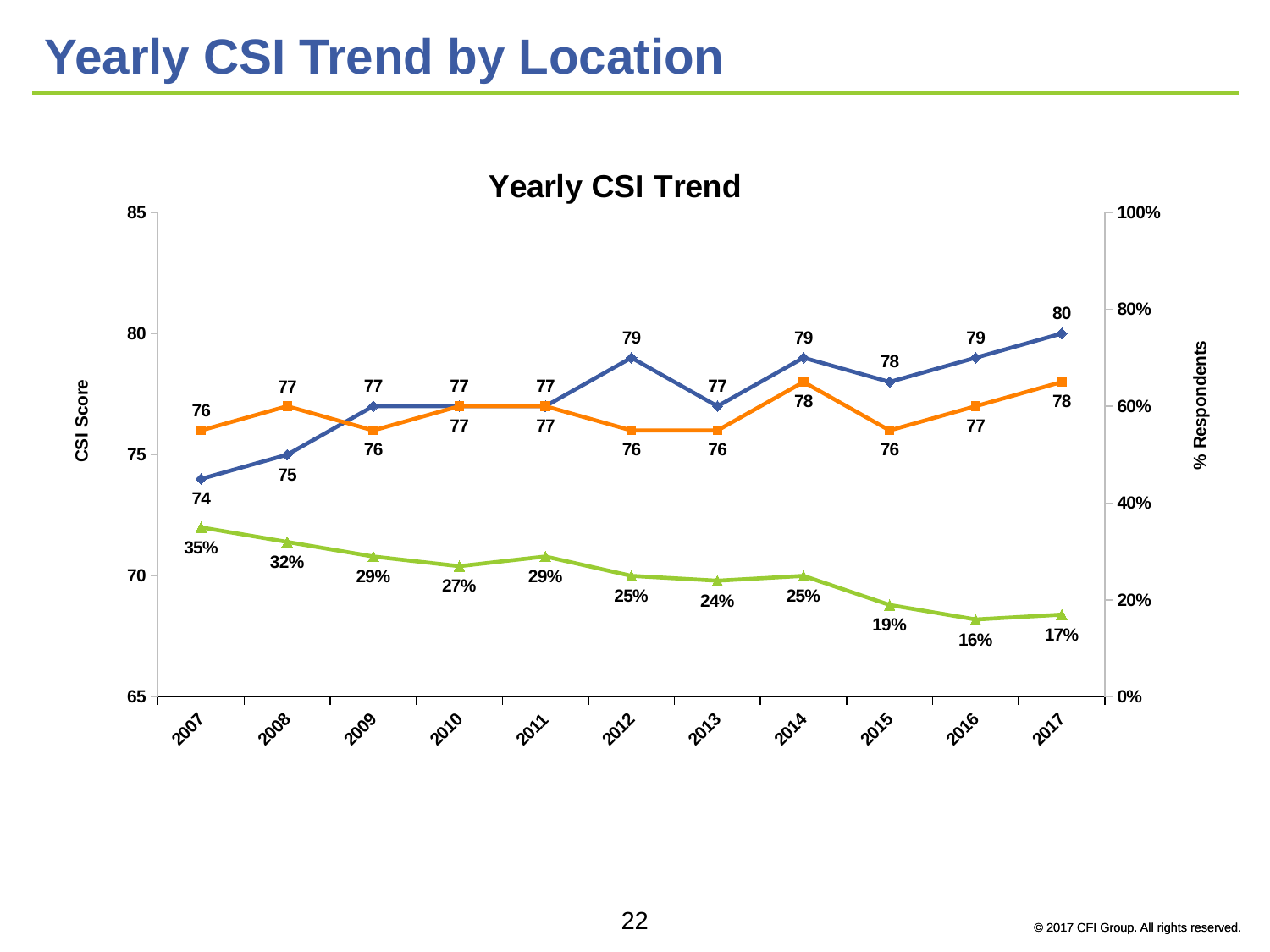
What is the value of the blue line in 2017? 80 In which year does the green line reach its lowest value? 2016 What is the title of the chart? Yearly CSI Trend Does the green line generally rise or fall from 2007 to 2017? fall Which is larger in 2012, the blue line's value or the orange line's value? the blue line's value What type of chart is shown on the slide? line chart How many years are shown on the x axis? 11 What percentage does the green line show for 2007? 35% In which year does the blue line reach its highest value? 2017 What is the value of the orange line in 2014? 78 What is the difference between the blue line's value in 2017 and its value in 2007? 6 What is the label of the right-hand vertical axis? % Respondents